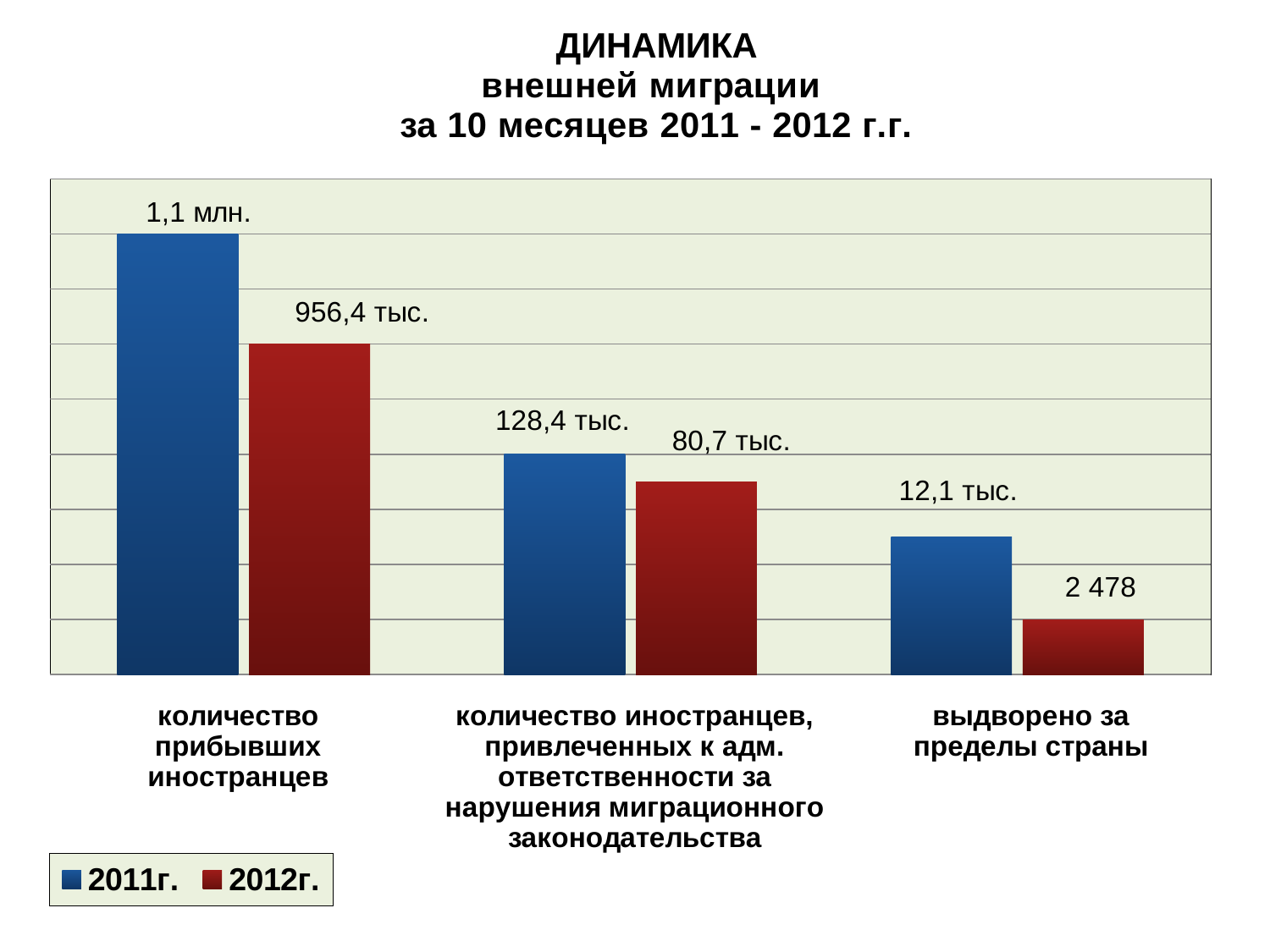
How many categories are shown on the x axis? 3 Which category has the lowest 2011г. value? выдворено за пределы страны What is the difference between the 2011г. and 2012г. values for «количество иностранцев, привлеченных к адм. ответственности за нарушения миграционного законодательства»? 47,7 тыс. What is the 2012г. value for «количество прибывших иностранцев»? 956,4 тыс. For «выдворено за пределы страны», which year has the larger value, 2011г. or 2012г.? 2011г. What is the 2012г. value for «выдворено за пределы страны»? 2 478 What kind of chart is shown on the slide? bar chart What is the 2011г. value for «количество иностранцев, привлеченных к адм. ответственности за нарушения миграционного законодательства»? 128,4 тыс. How many series does the legend list? 2 Which category has the highest 2012г. value? количество прибывших иностранцев What is the 2011г. value for «количество прибывших иностранцев»? 1,1 млн. What is the 2011г. value for «выдворено за пределы страны»? 12,1 тыс.